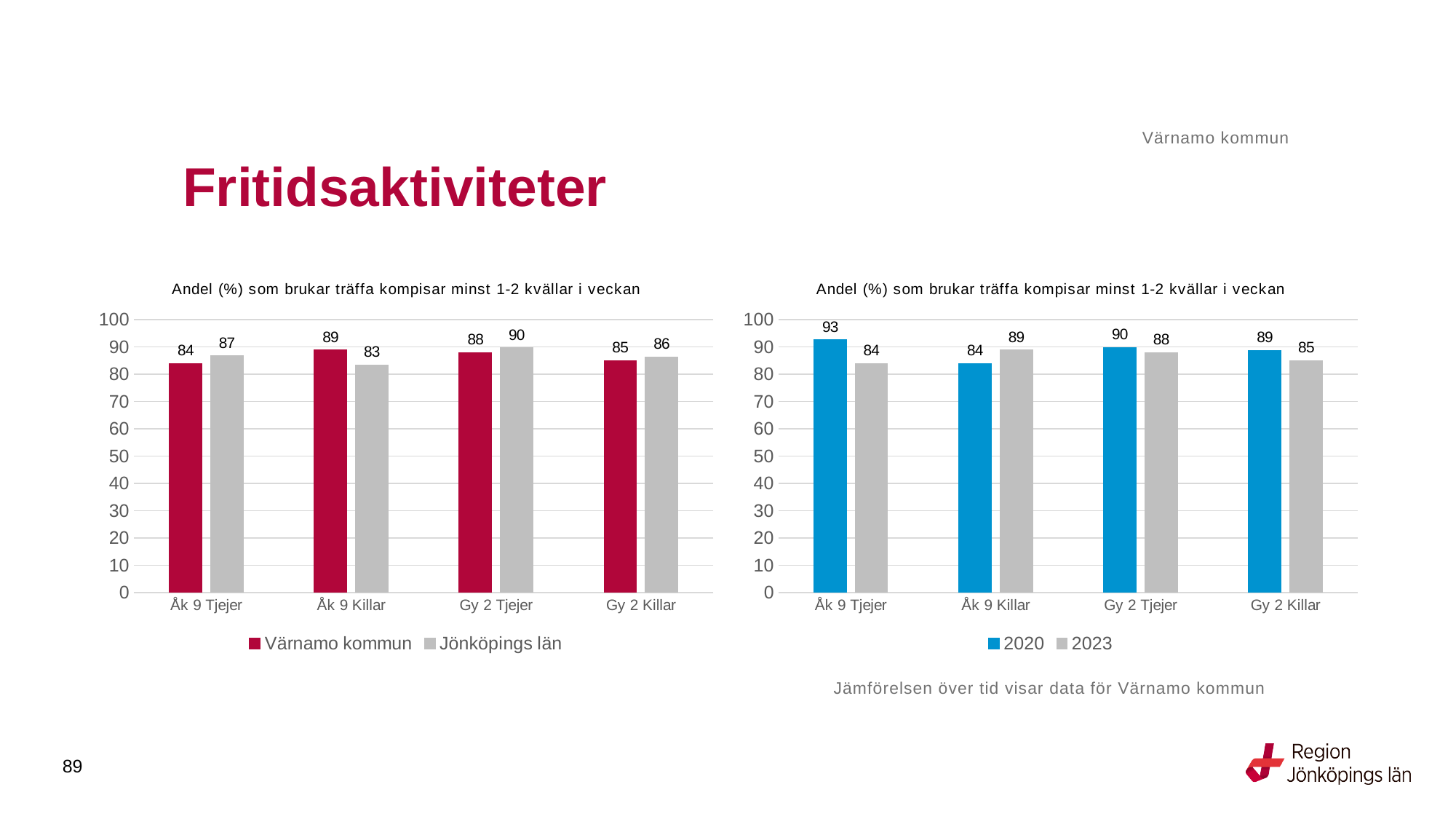
In the right chart, what is the value for 2020 for Åk 9 Tjejer? 93 In the left chart, what is the difference between Värnamo kommun and Jönköpings län for Åk 9 Killar? 6 What kind of chart is the right chart? Bar chart In the left chart, what is the value for Jönköpings län for Gy 2 Tjejer? 90 In the left chart, what is the value for Värnamo kommun for Åk 9 Killar? 89 In the right chart, what is the value for 2023 for Gy 2 Killar? 85 How many categories are shown on the x axis of the right chart? 4 In the right chart, what is the difference between the 2020 and 2023 values for Åk 9 Tjejer? 9 In the left chart, which is larger for Åk 9 Tjejer: Värnamo kommun or Jönköpings län? Jönköpings län In the right chart, which category has the highest value for 2020? Åk 9 Tjejer How many series does the legend of the left chart list? 2 In the left chart, which category has the lowest value for Jönköpings län? Åk 9 Killar